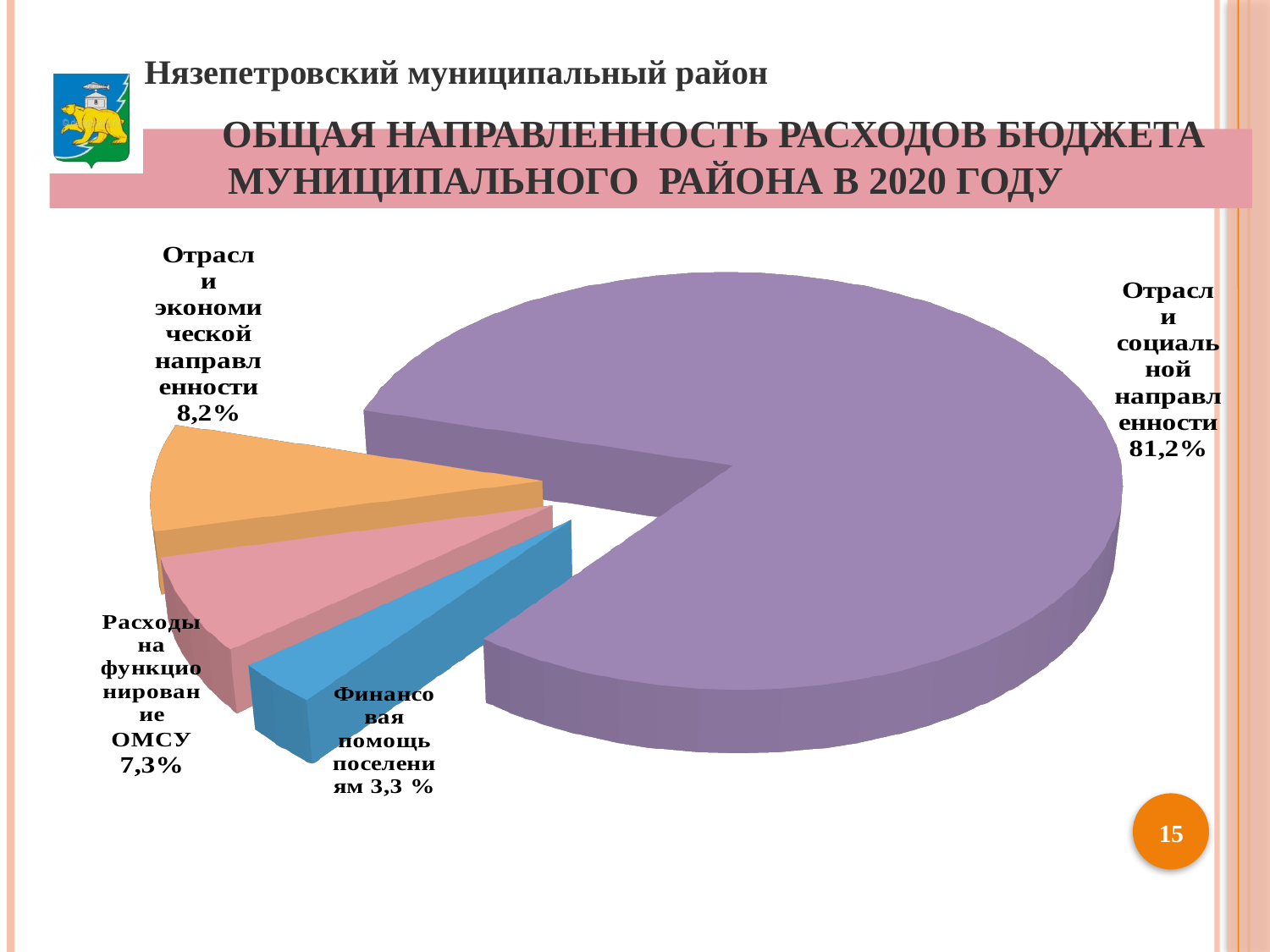
What colour is the slice for 'Финансовая помощь поселениям'? Blue What share of the pie does 'Отрасли социальной направленности' take? 81,2% Which category has the smallest slice of the pie? Финансовая помощь поселениям What kind of chart is shown on the slide? Pie chart What is the value shown for 'Расходы на функционирование ОМСУ'? 7,3% How many slices does the pie chart have? 4 Which is larger: 'Отрасли экономической направленности' or 'Расходы на функционирование ОМСУ'? Отрасли экономической направленности What is the difference in percentage points between 'Отрасли экономической направленности' and 'Расходы на функционирование ОМСУ'? 0,9 What is the difference in percentage points between 'Отрасли социальной направленности' and 'Финансовая помощь поселениям'? 77,9 What is the value shown for 'Финансовая помощь поселениям'? 3,3 % Which category has the largest slice of the pie? Отрасли социальной направленности What is the value shown for 'Отрасли экономической направленности'? 8,2%